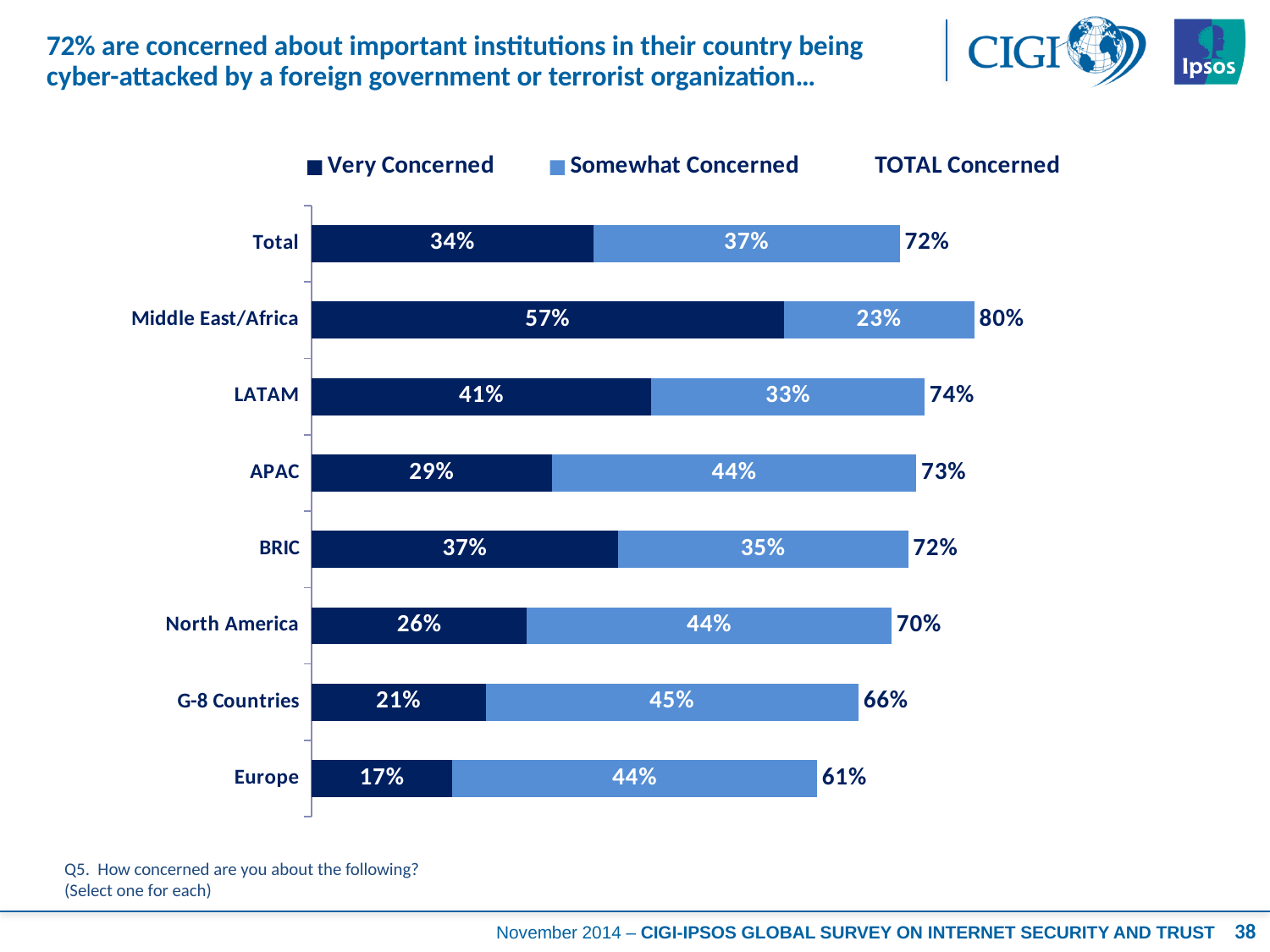
Which region has the lowest TOTAL Concerned value? Europe What is the Very Concerned value for Middle East/Africa? 57% Which region has the highest Very Concerned value? Middle East/Africa What is the TOTAL Concerned value shown for the Total bar? 72% What is the TOTAL Concerned value for Europe? 61% What is the difference between the Very Concerned values for LATAM and APAC? 12% Which is larger, the Somewhat Concerned value for BRIC or for North America? North America What is the Somewhat Concerned value for G-8 Countries? 45% How many series does the legend list as bar segments? 2 Which colour represents the Very Concerned series? Dark navy blue What kind of chart is shown on the slide? Stacked bar chart How many regional categories, including Total, are shown on the chart? 8